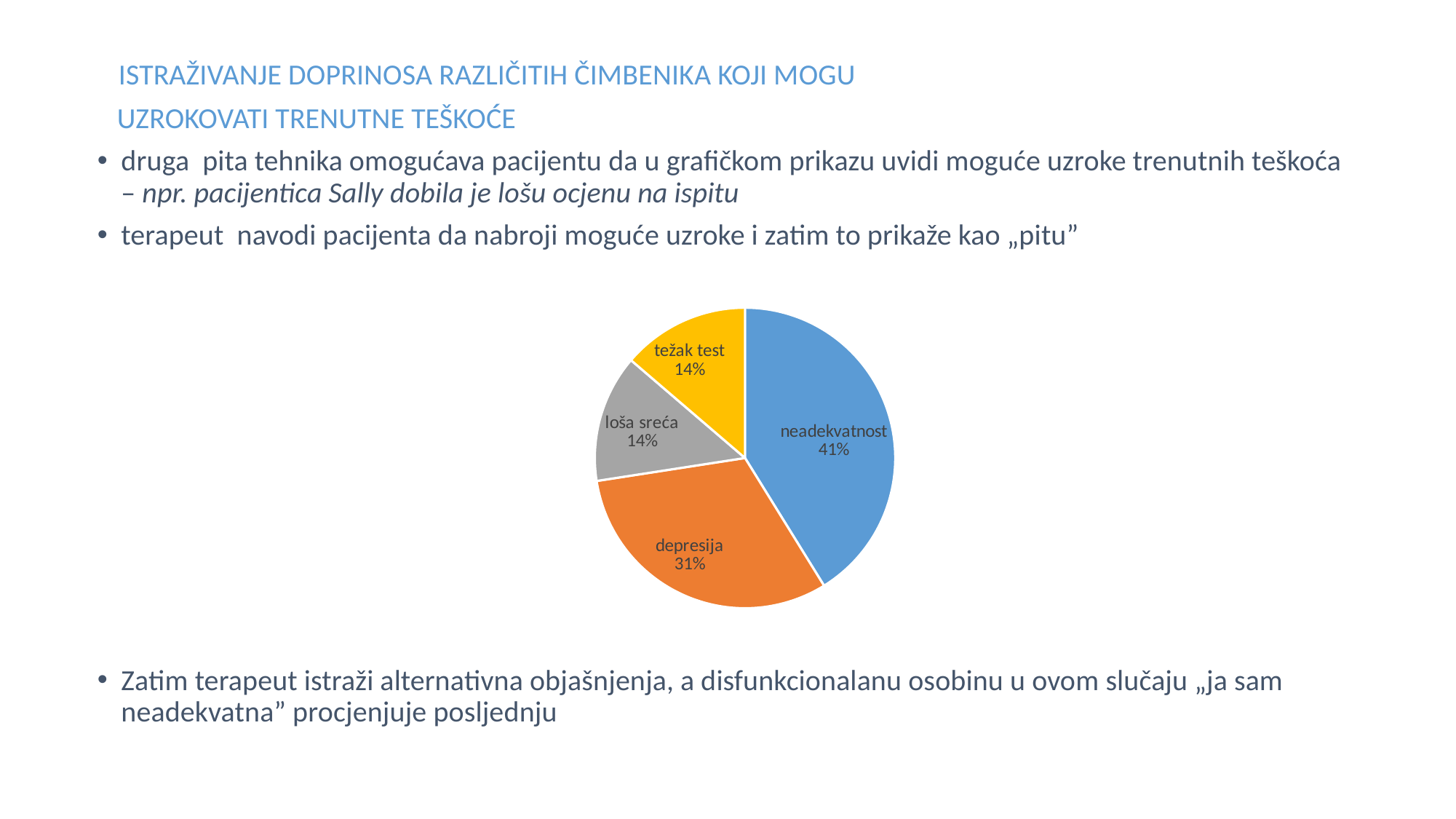
What percentage is shown for the "loša sreća" slice? 14% What share of the pie does the slice labelled "neadekvatnost" represent? 41% Which slice of the pie chart is the largest? neadekvatnost What percentage is shown for the "težak test" slice? 14% How many slices does the pie chart have? 4 By how many percentage points is the "neadekvatnost" slice larger than the "depresija" slice? 10 What is the combined share of the "neadekvatnost" and "depresija" slices? 72% What percentage is shown for the "depresija" slice? 31% What colour is the "depresija" slice in the pie chart? orange What colour is the "neadekvatnost" slice in the pie chart? blue Which slice is larger, "depresija" or "težak test"? depresija What kind of chart is shown on the slide? pie chart